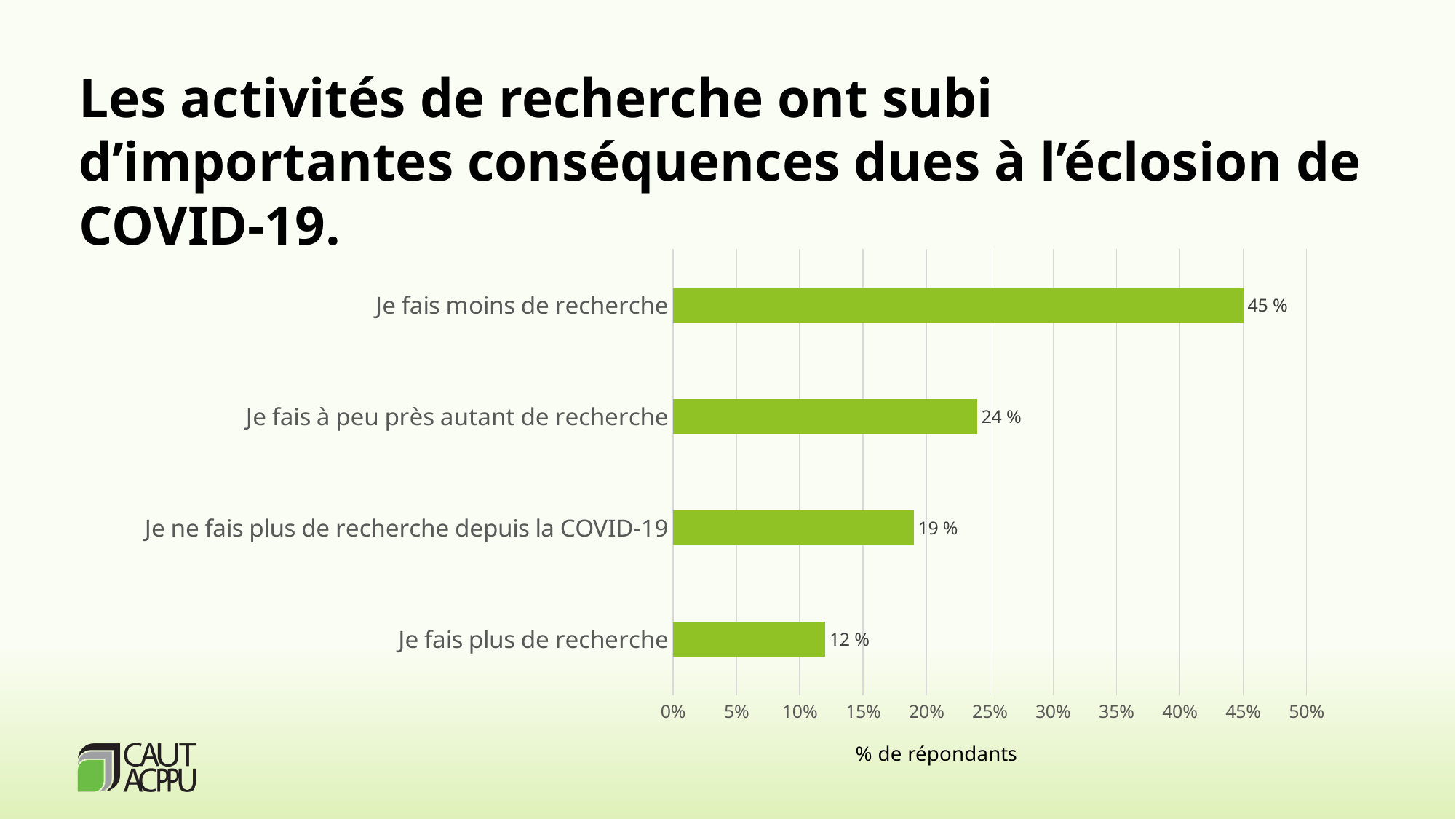
How many categories are shown in the chart? 4 Which category has the highest percentage of respondents? Je fais moins de recherche Which category has the lowest percentage of respondents? Je fais plus de recherche What is the value for "Je fais à peu près autant de recherche"? 24 % What is the label of the horizontal axis? % de répondants What is the value for "Je ne fais plus de recherche depuis la COVID-19"? 19 % Which is larger: "Je fais à peu près autant de recherche" or "Je ne fais plus de recherche depuis la COVID-19"? Je fais à peu près autant de recherche What is the difference between "Je fais moins de recherche" and "Je fais plus de recherche"? 33 % What percentage of respondents said "Je fais moins de recherche"? 45 % What is the value for "Je fais plus de recherche"? 12 % What is the difference between "Je fais à peu près autant de recherche" and "Je ne fais plus de recherche depuis la COVID-19"? 5 % What kind of chart is shown on the slide? Bar chart